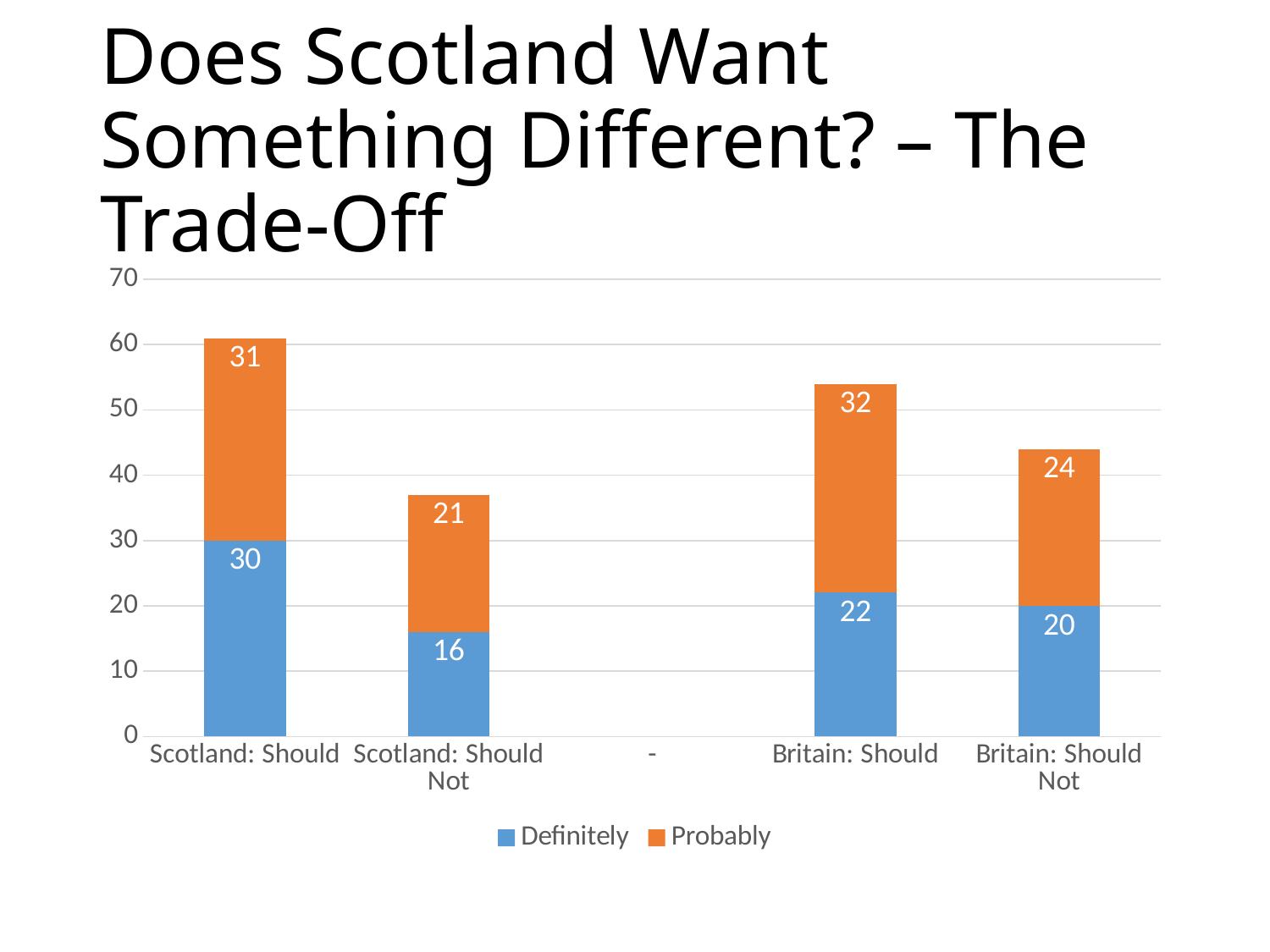
What is the total of the stacked bar for Britain: Should Not? 44 What is the total of the stacked bar for Scotland: Should? 61 What is the Definitely value for Scotland: Should? 30 Which is larger, the Definitely value for Britain: Should or the Definitely value for Scotland: Should Not? Britain: Should Which category has the lowest Probably value? Scotland: Should Not What is the Probably value for Britain: Should? 32 What is the Probably value for Scotland: Should Not? 21 What is the difference between the Probably values for Britain: Should and Britain: Should Not? 8 How many series does the legend list? 2 What kind of chart is shown on the slide? Stacked bar chart Which category has the highest Definitely value? Scotland: Should What is the Definitely value for Britain: Should Not? 20